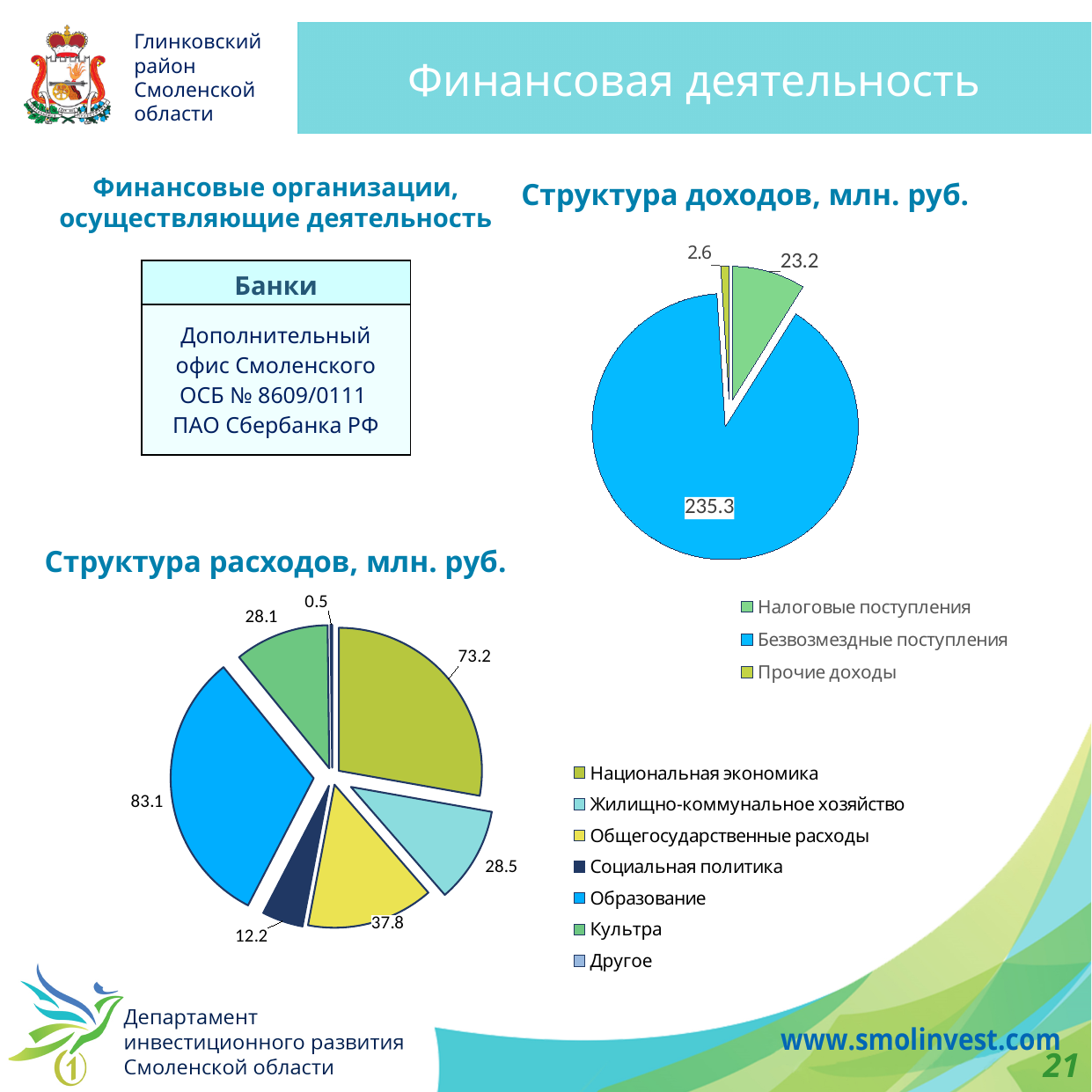
What kind of chart is 'Структура расходов, млн. руб.'? Pie chart On the chart 'Структура расходов, млн. руб.', what is the value for Социальная политика? 12.2 On the chart 'Структура расходов, млн. руб.', how many categories does the legend list? 7 On the chart 'Структура доходов, млн. руб.', what is the value for Налоговые поступления? 23.2 On the chart 'Структура расходов, млн. руб.', which is larger: Национальная экономика or Общегосударственные расходы? Национальная экономика On the chart 'Структура доходов, млн. руб.', how many categories does the legend list? 3 On the chart 'Структура расходов, млн. руб.', what is the value for Образование? 83.1 On the chart 'Структура расходов, млн. руб.', which category has the largest value? Образование On the chart 'Структура доходов, млн. руб.', what is the value for Безвозмездные поступления? 235.3 On the chart 'Структура доходов, млн. руб.', which category has the smallest value? Прочие доходы On the chart 'Структура расходов, млн. руб.', what is the difference between Образование and Национальная экономика? 9.9 On the chart 'Структура доходов, млн. руб.', what is the difference between Безвозмездные поступления and Налоговые поступления? 212.1